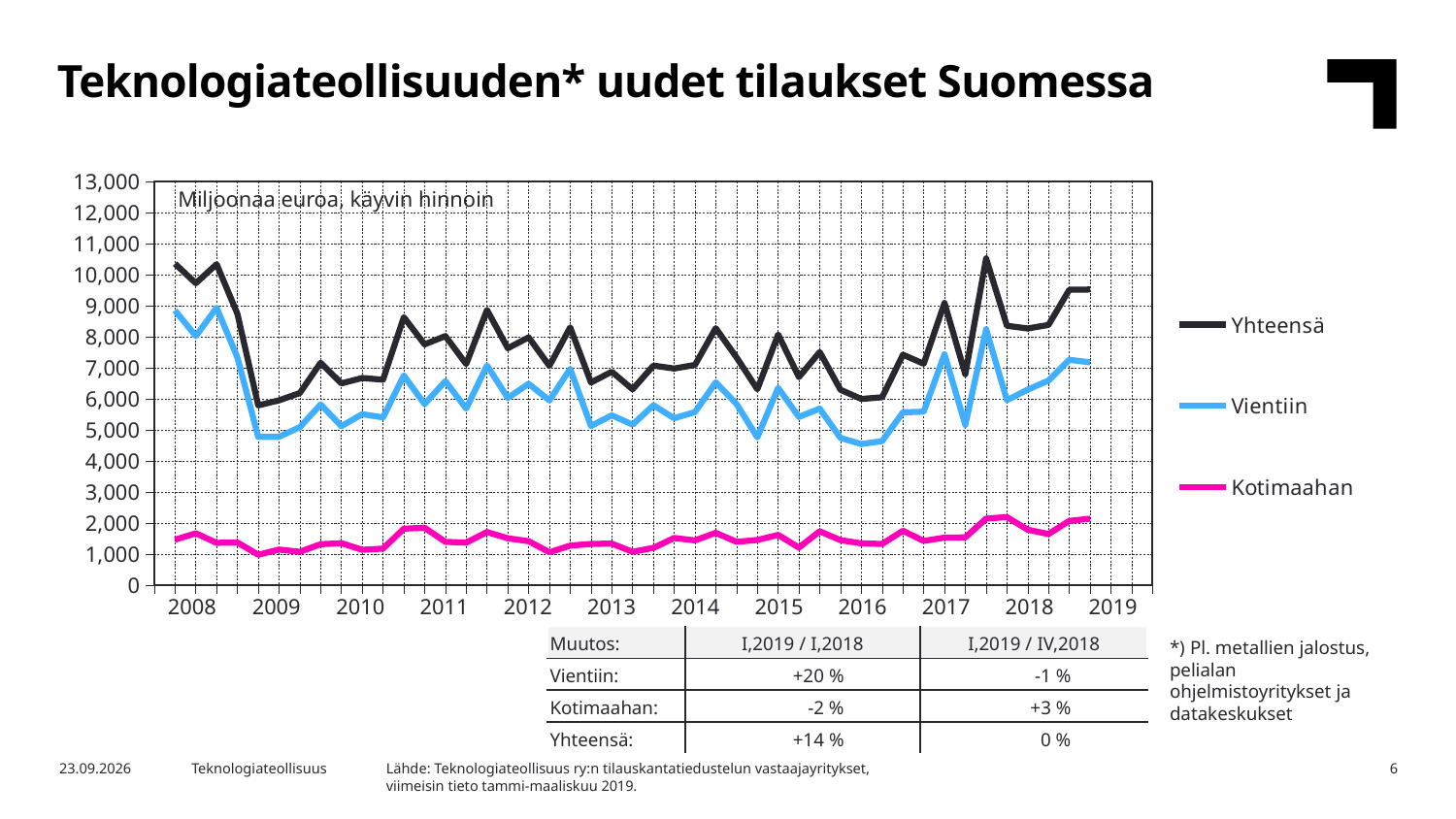
What unit label is printed inside the chart area? Miljoonaa euroa, käyvin hinnoin Which series has the highest values throughout the chart? Yhteensä Which series has the lowest values throughout the chart? Kotimaahan Is the Yhteensä value at the start of 2008 greater or less than 10,000? greater Does the Yhteensä line rise or fall between the start of 2008 and the start of 2009? Fall Is the lowest Vientiin value in 2009 greater or less than 6,000? less What kind of chart is shown on the slide? Line chart What are the three series named in the chart legend? Yhteensä, Vientiin, Kotimaahan How many series does the legend of the chart list? 3 Which series is larger in 2015, Vientiin or Kotimaahan? Vientiin How many year labels are shown on the x axis? 12 Is the value of Kotimaahan ever greater or less than 3,000 over the whole period? less